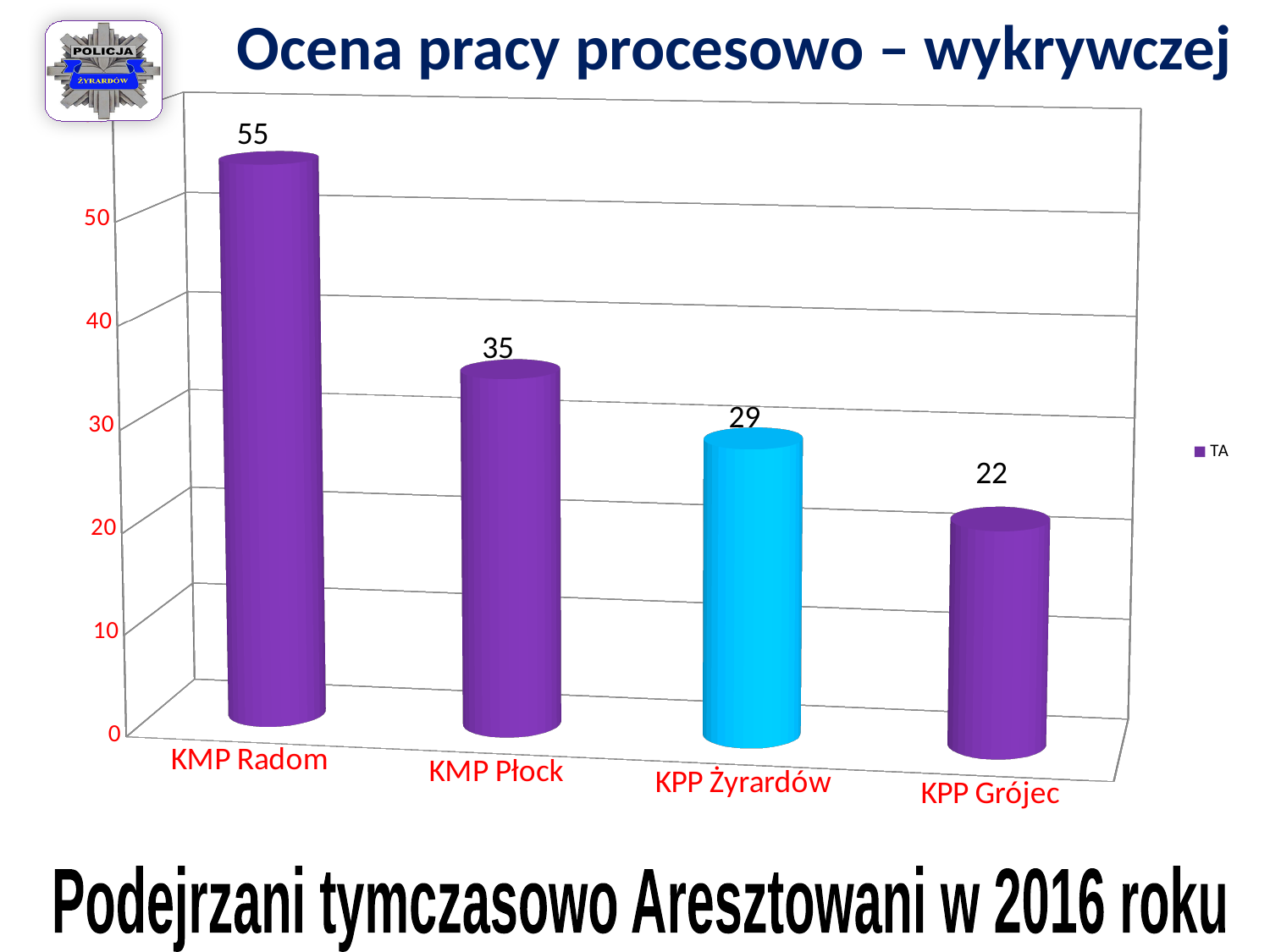
What is the difference between the values for KMP Radom and KMP Płock? 20 What is the value for KPP Grójec? 22 What is the value for KMP Radom? 55 How many series does the legend list? 1 Which category has the lowest value? KPP Grójec Which category has the highest value? KMP Radom Do the values rise or fall from left to right along the x axis? fall Which is larger, the value for KPP Żyrardów or the value for KPP Grójec? KPP Żyrardów What is the value for KMP Płock? 35 How many categories are shown on the x axis? 4 What is the value for KPP Żyrardów? 29 What kind of chart is shown? bar chart